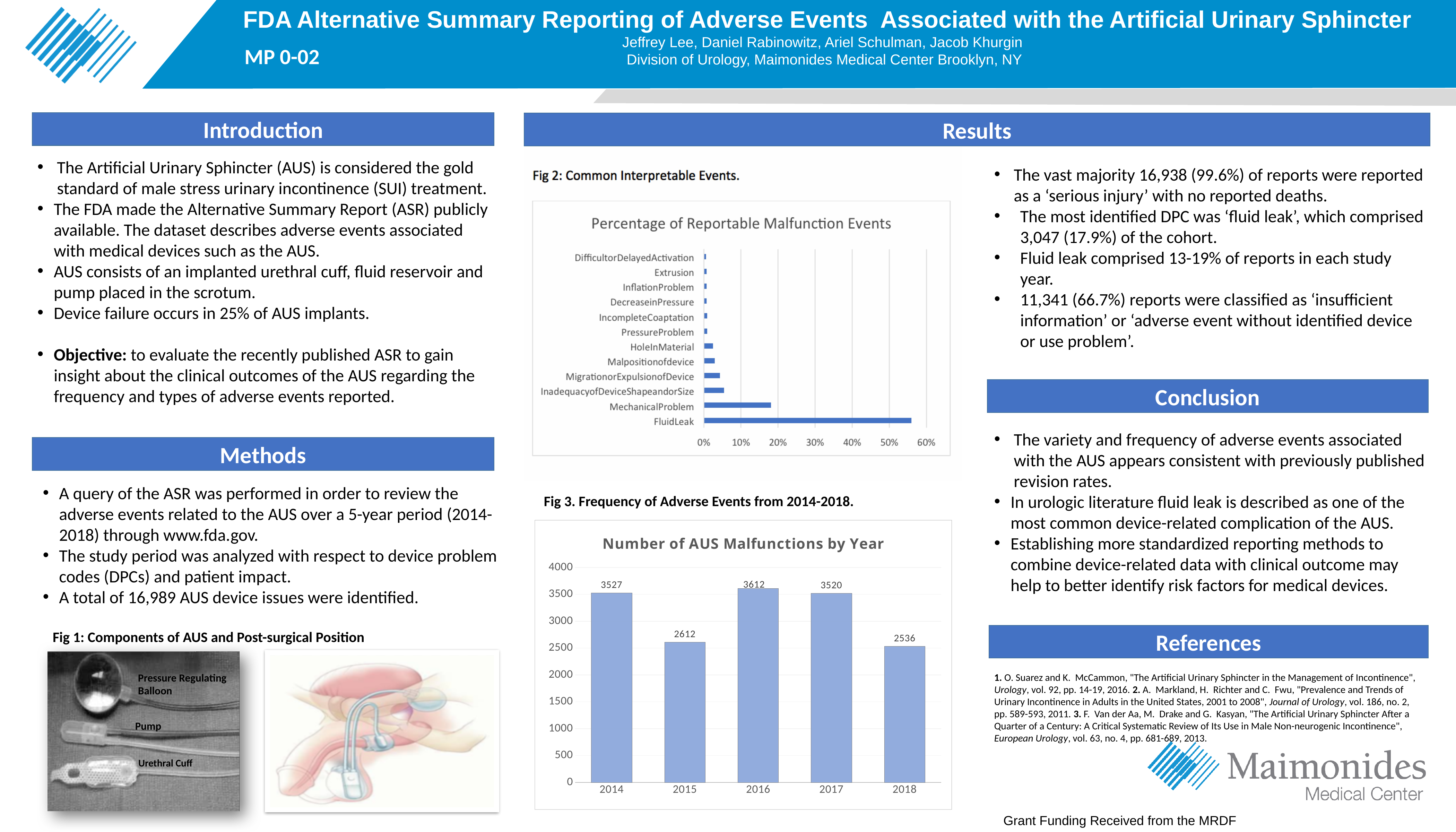
In the 'Number of AUS Malfunctions by Year' chart, what is the value for 2016? 3612 What kind of chart is the 'Percentage of Reportable Malfunction Events' chart? bar chart In the 'Number of AUS Malfunctions by Year' chart, what is the difference between the values for 2016 and 2015? 1000 In the 'Number of AUS Malfunctions by Year' chart, which is larger, the value for 2014 or the value for 2017? 2014 In the 'Number of AUS Malfunctions by Year' chart, what is the value for 2018? 2536 In the 'Number of AUS Malfunctions by Year' chart, how many years are shown? 5 In the 'Percentage of Reportable Malfunction Events' chart, which category has the highest percentage? FluidLeak In the 'Percentage of Reportable Malfunction Events' chart, is the value for FluidLeak greater or less than 50%? greater In the 'Percentage of Reportable Malfunction Events' chart, is the value for MechanicalProblem greater or less than 30%? less In the 'Number of AUS Malfunctions by Year' chart, does the value rise or fall from 2017 to 2018? fall In the 'Number of AUS Malfunctions by Year' chart, which year has the lowest number of malfunctions? 2018 In the 'Number of AUS Malfunctions by Year' chart, which year has the highest number of malfunctions? 2016